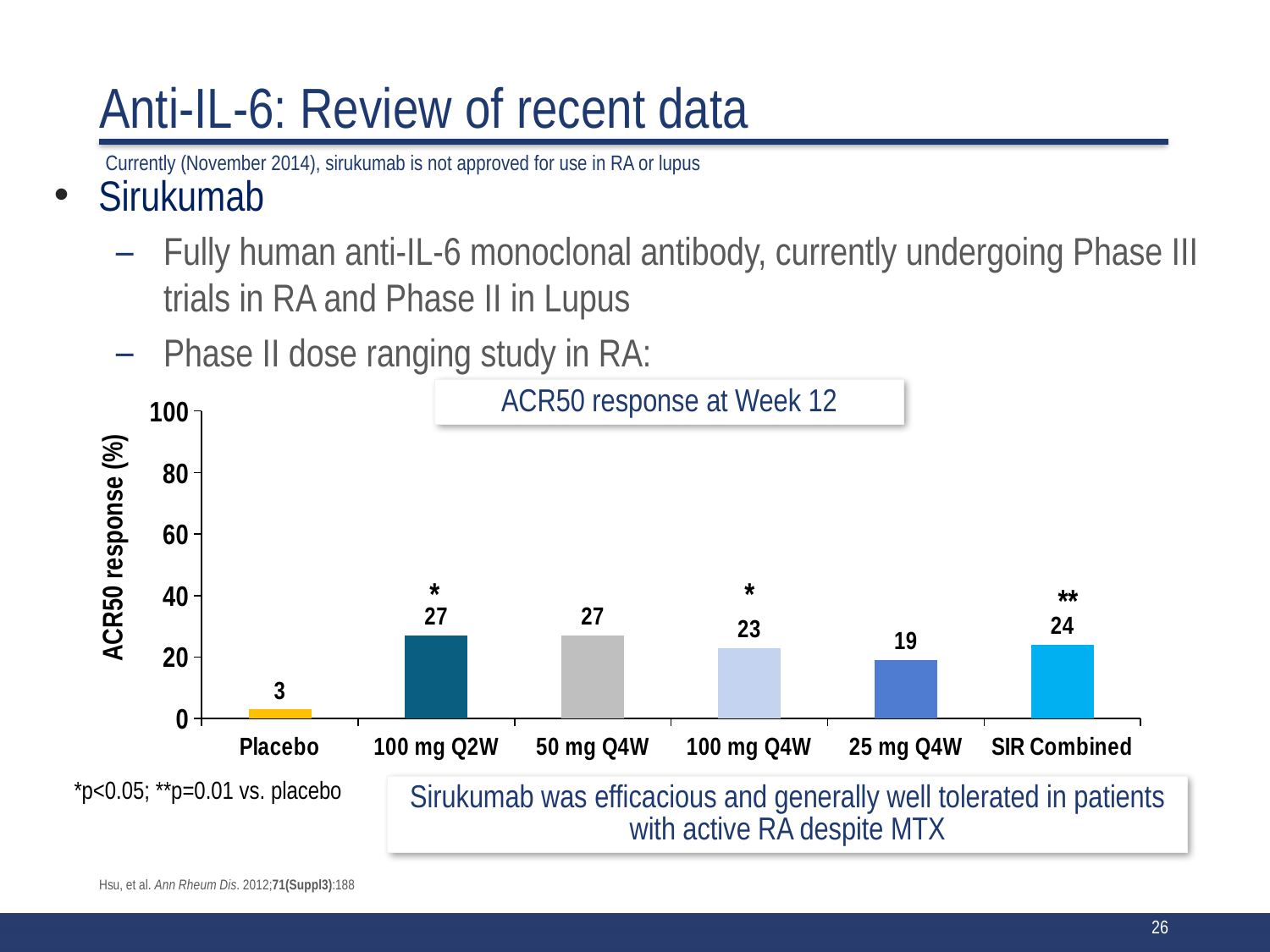
What is the ACR50 response for 25 mg Q4W? 19 What is the difference in ACR50 response between SIR Combined and 25 mg Q4W? 5 What is the ACR50 response for SIR Combined? 24 What is the title of the chart? ACR50 response at Week 12 Which has a higher ACR50 response, 100 mg Q4W or 25 mg Q4W? 100 mg Q4W What is the ACR50 response for Placebo? 3 Which category has the lowest ACR50 response? Placebo Is the value for 50 mg Q4W greater or less than 20? greater What is the difference in ACR50 response between 100 mg Q2W and Placebo? 24 What is the ACR50 response for 100 mg Q4W? 23 How many categories are shown on the x axis? 6 What kind of chart is shown on the slide? Bar chart